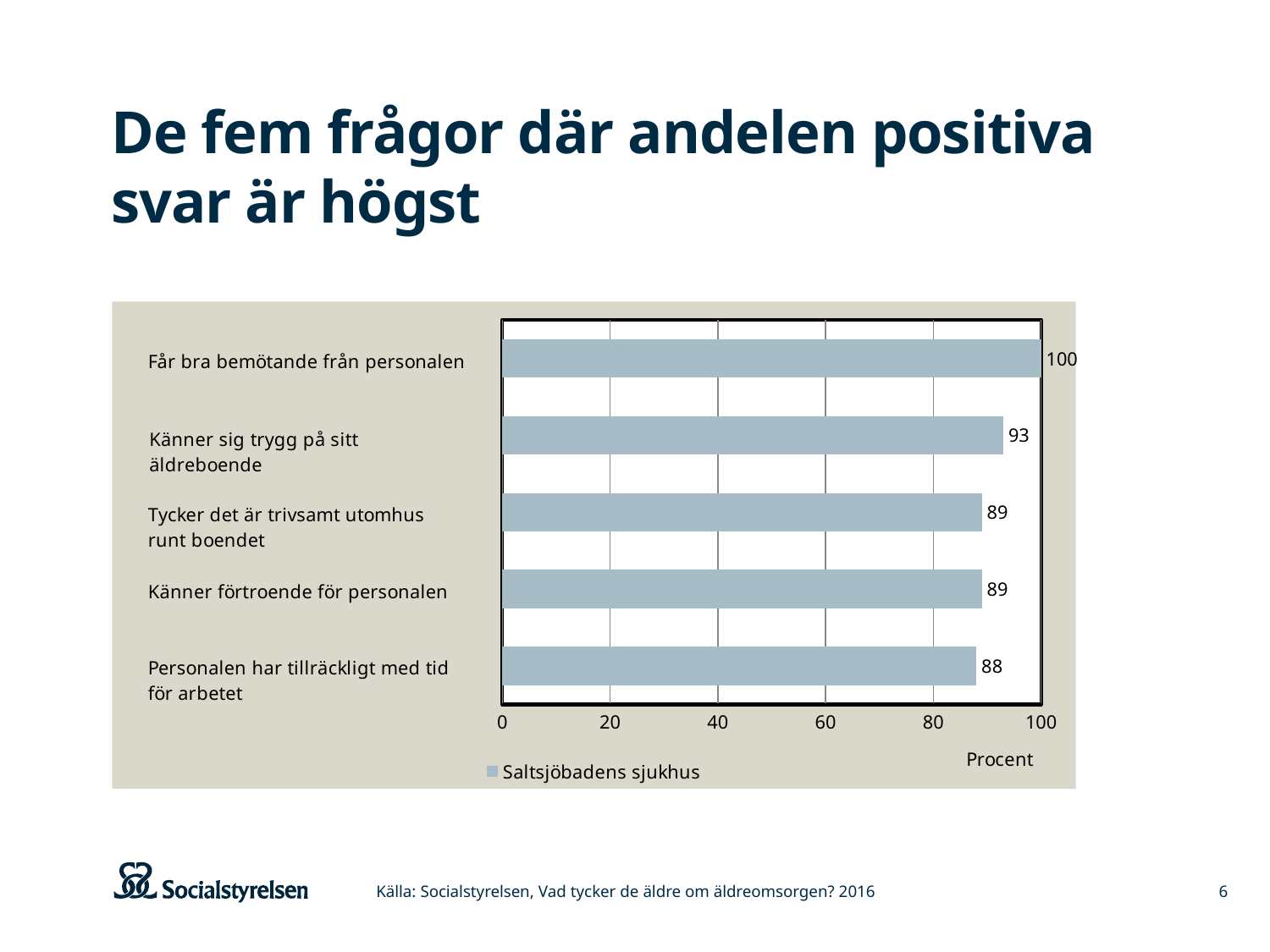
What is the value for "Känner förtroende för personalen"? 89 What is the value for "Personalen har tillräckligt med tid för arbetet"? 88 What is the name of the series shown in the legend? Saltsjöbadens sjukhus What is the value for "Känner sig trygg på sitt äldreboende"? 93 How many series does the legend list? 1 Which category has the highest value? Får bra bemötande från personalen Which is larger: the value for "Känner sig trygg på sitt äldreboende" or the value for "Tycker det är trivsamt utomhus runt boendet"? Känner sig trygg på sitt äldreboende What is the difference between the values for "Får bra bemötande från personalen" and "Känner sig trygg på sitt äldreboende"? 7 What is the value for "Får bra bemötande från personalen"? 100 What kind of chart is shown on the slide? Bar chart How many categories are shown in the chart? 5 Which category has the lowest value? Personalen har tillräckligt med tid för arbetet